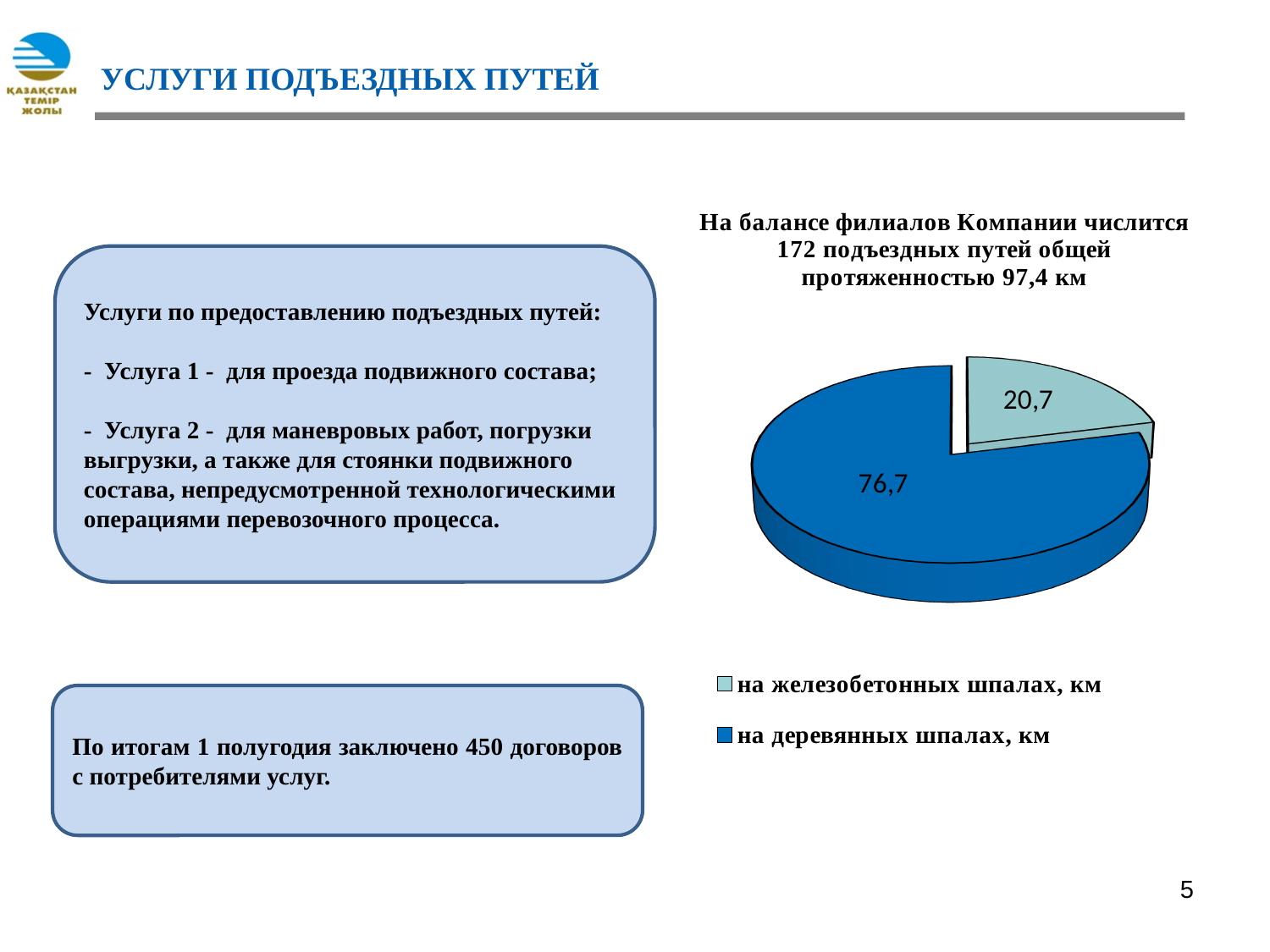
What is the value for 'на деревянных шпалах, км' in the pie chart? 76,7 How many entries does the legend of the pie chart list? 2 What kind of chart is shown on the slide? pie chart What share of the pie does 'на железобетонных шпалах, км' represent, to the nearest whole percent? 21% Which category has the largest slice in the pie chart? на деревянных шпалах, км Which is larger: the value for 'на деревянных шпалах, км' or the value for 'на железобетонных шпалах, км'? на деревянных шпалах, км What is the value for 'на железобетонных шпалах, км' in the pie chart? 20,7 What colour is the slice for 'на деревянных шпалах, км' in the pie chart? dark blue What is the difference between the value for 'на деревянных шпалах, км' and the value for 'на железобетонных шпалах, км'? 56,0 Which category has the smallest slice in the pie chart? на железобетонных шпалах, км What is the total of the two values shown in the pie chart? 97,4 How many slices does the pie chart have? 2